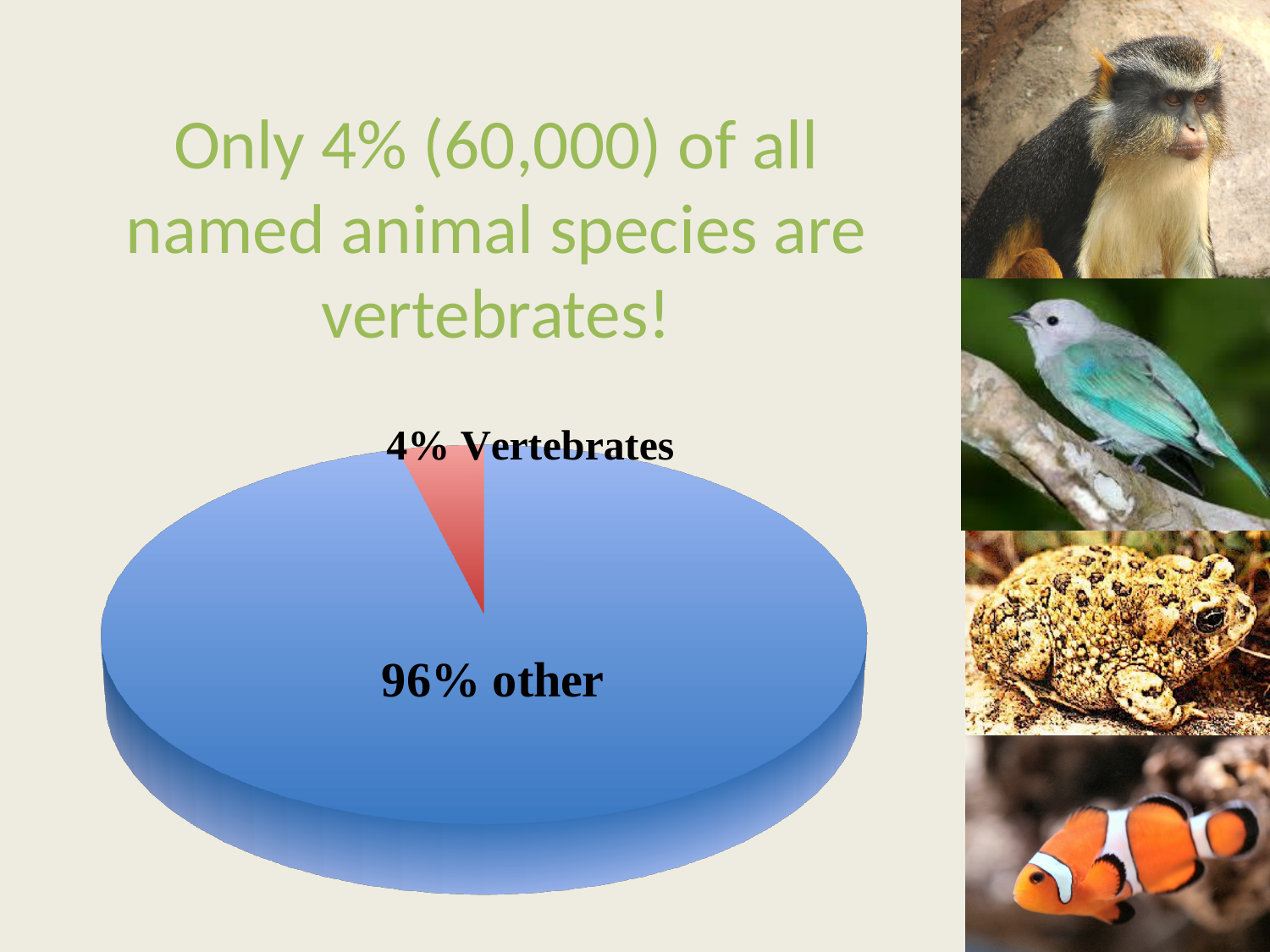
What colour is the Vertebrates slice of the pie? red What share of the pie is labelled other? 96% Is the share for Vertebrates greater or less than 10%? less What share of the pie is labelled Vertebrates? 4% What is the difference in percentage points between the other slice and the Vertebrates slice? 92 Is the share for other greater or less than 50%? greater Which is larger, the Vertebrates slice or the other slice? other What kind of chart is shown on the slide? pie chart How many slices does the pie chart have? 2 What colour is the other slice of the pie? blue Which slice of the pie is the largest? other Which slice of the pie is the smallest? Vertebrates